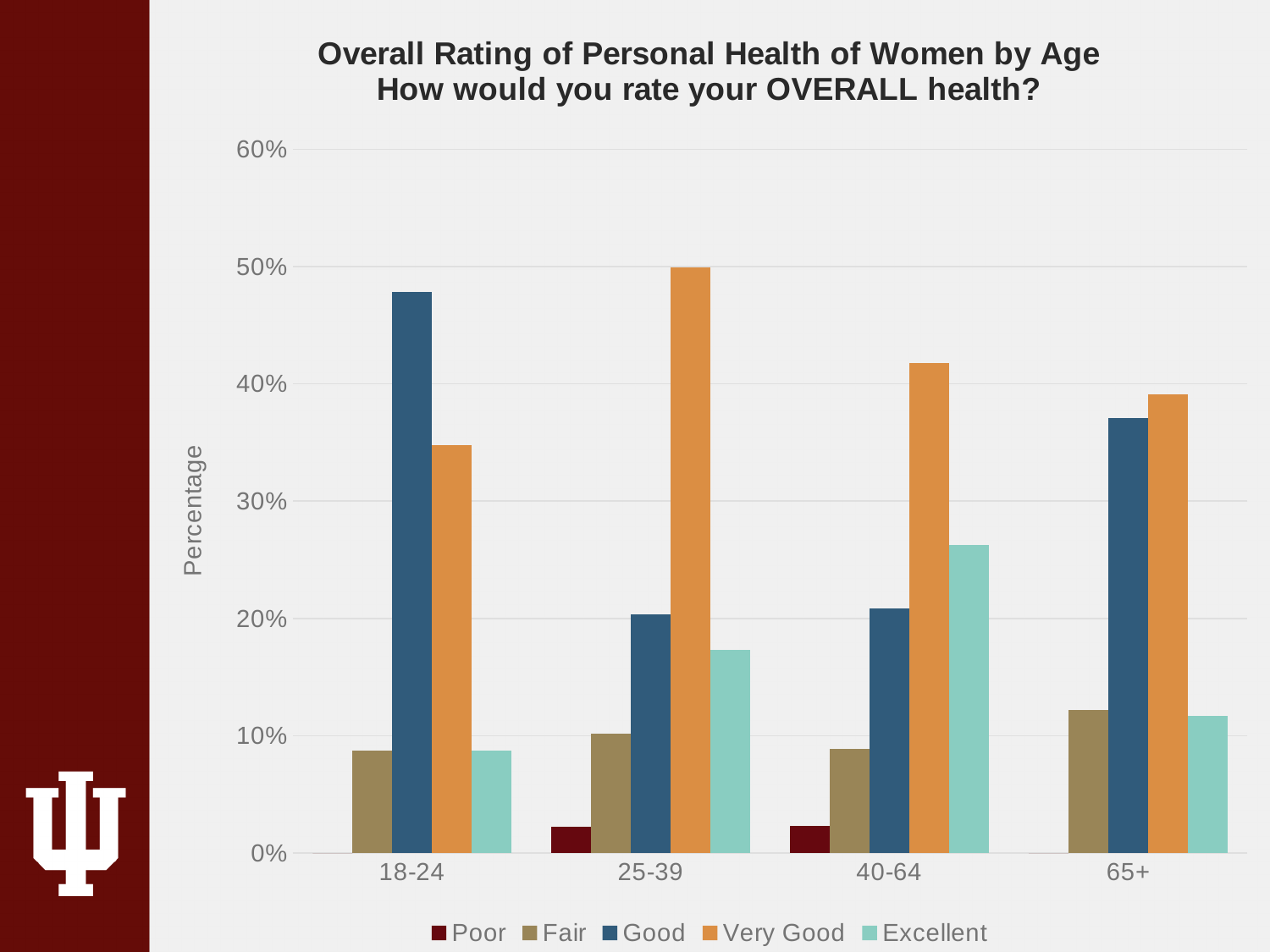
What is the label on the y axis? Percentage Which rating has the highest value for the 18-24 age group? Good How many series does the legend list? 5 Is the Good value for the 25-39 age group greater or less than 30%? less What kind of chart is shown on the slide? bar chart How many age groups are shown on the x axis? 4 Which is larger: the Excellent value for 40-64 or the Excellent value for 25-39? 40-64 Which age group has the highest Very Good value? 25-39 Which rating has the lowest value for the 25-39 age group? Poor For the 18-24 age group, which is larger: Good or Very Good? Good Is the Good value for the 18-24 age group greater or less than 40%? greater Which rating has the highest value for the 40-64 age group? Very Good